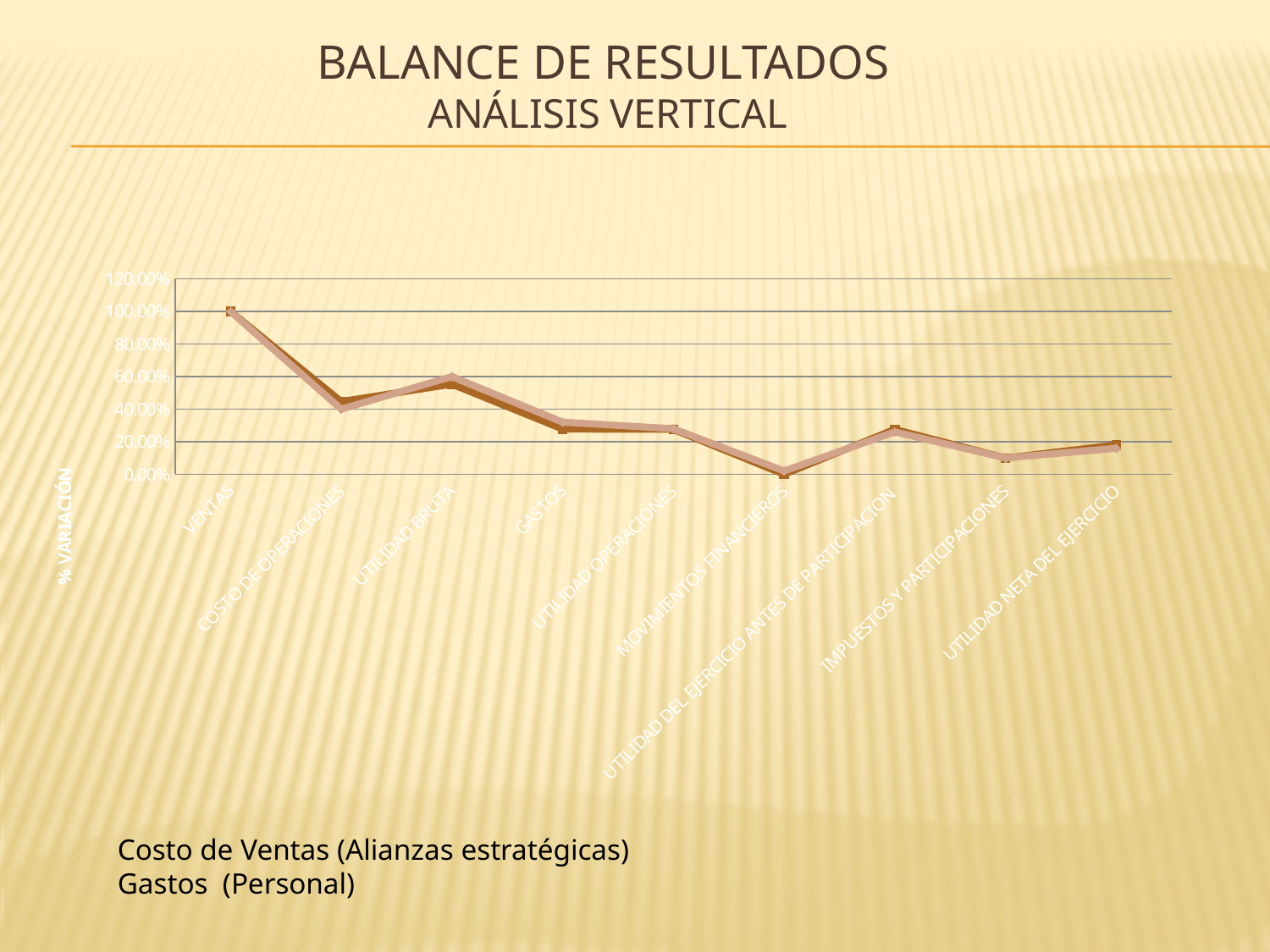
Overall, do the values rise or fall from VENTAS to UTILIDAD NETA DEL EJERCICIO along the x axis? fall Which category has the highest value in the chart? VENTAS Which is larger, the value for IMPUESTOS Y PARTICIPACIONES or the value for UTILIDAD NETA DEL EJERCICIO? UTILIDAD NETA DEL EJERCICIO Which is larger, the value for COSTO DE OPERACIONES or the value for UTILIDAD BRUTA? UTILIDAD BRUTA What is the label on the vertical axis of the chart? % VARIACIÓN What is the value for VENTAS in the chart? 100.00% Is the value for UTILIDAD BRUTA greater or less than 40.00%? greater Which category has the lowest value in the chart? MOVIMIENTOS FINANCIEROS How many categories are plotted along the x axis of the chart? 9 Is the value for COSTO DE OPERACIONES greater or less than 60.00%? less Is the value for IMPUESTOS Y PARTICIPACIONES greater or less than 20.00%? less What kind of chart is shown on the slide? line chart